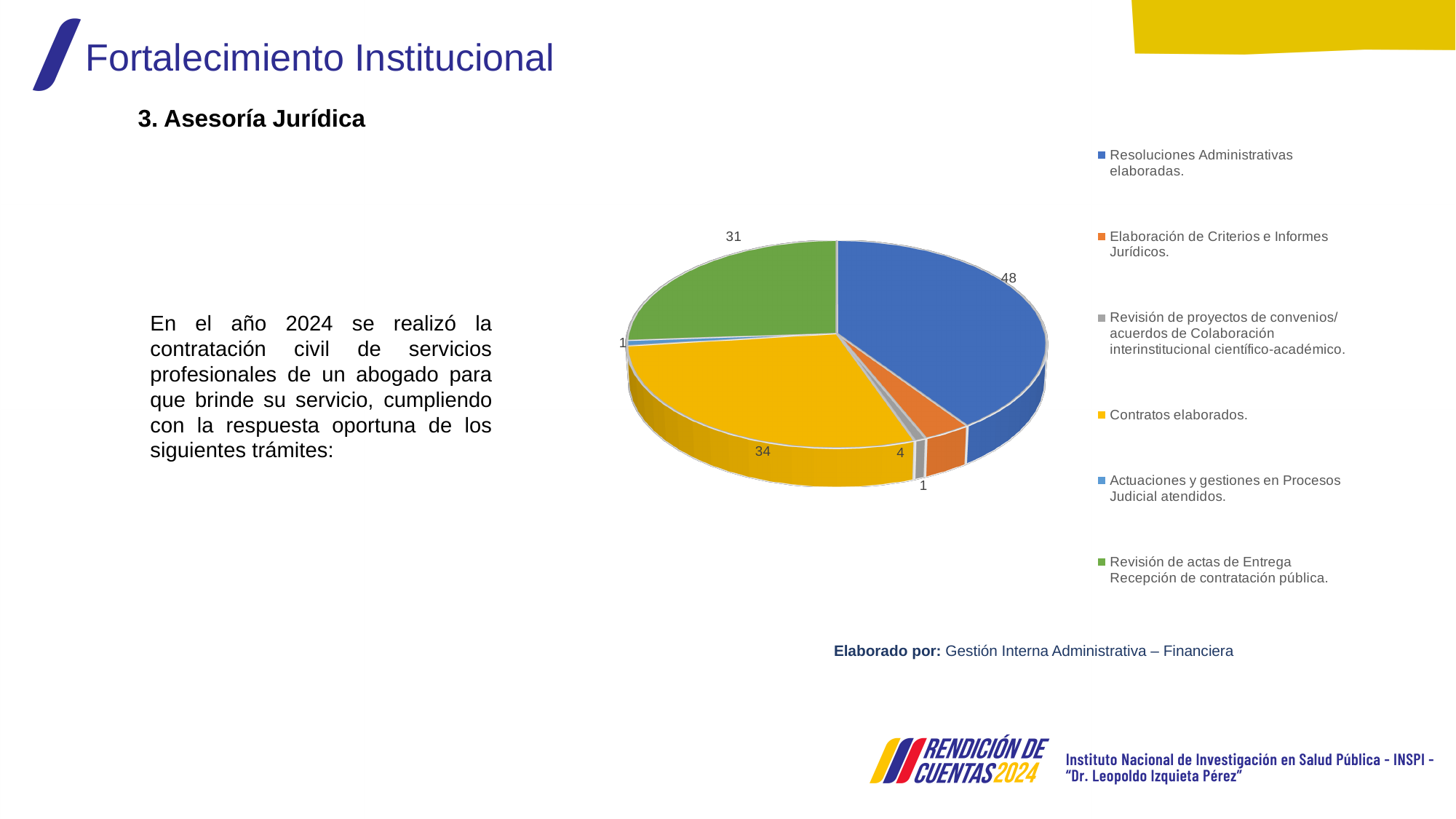
What is the difference between the values for Contratos elaborados and Revisión de actas de Entrega Recepción de contratación pública? 3 What value is shown for Revisión de actas de Entrega Recepción de contratación pública? 31 What value is shown for Contratos elaborados? 34 What colour represents Contratos elaborados in the pie chart? Yellow What is the smallest value labelled on the pie chart? 1 How many categories does the legend list? 6 What is the difference between the values for Resoluciones Administrativas elaboradas and Contratos elaborados? 14 What value is shown for Elaboración de Criterios e Informes Jurídicos? 4 What value is shown for Resoluciones Administrativas elaboradas? 48 Which category has the largest slice of the pie? Resoluciones Administrativas elaboradas What kind of chart is shown on the slide? Pie chart Which is larger: Contratos elaborados or Revisión de actas de Entrega Recepción de contratación pública? Contratos elaborados